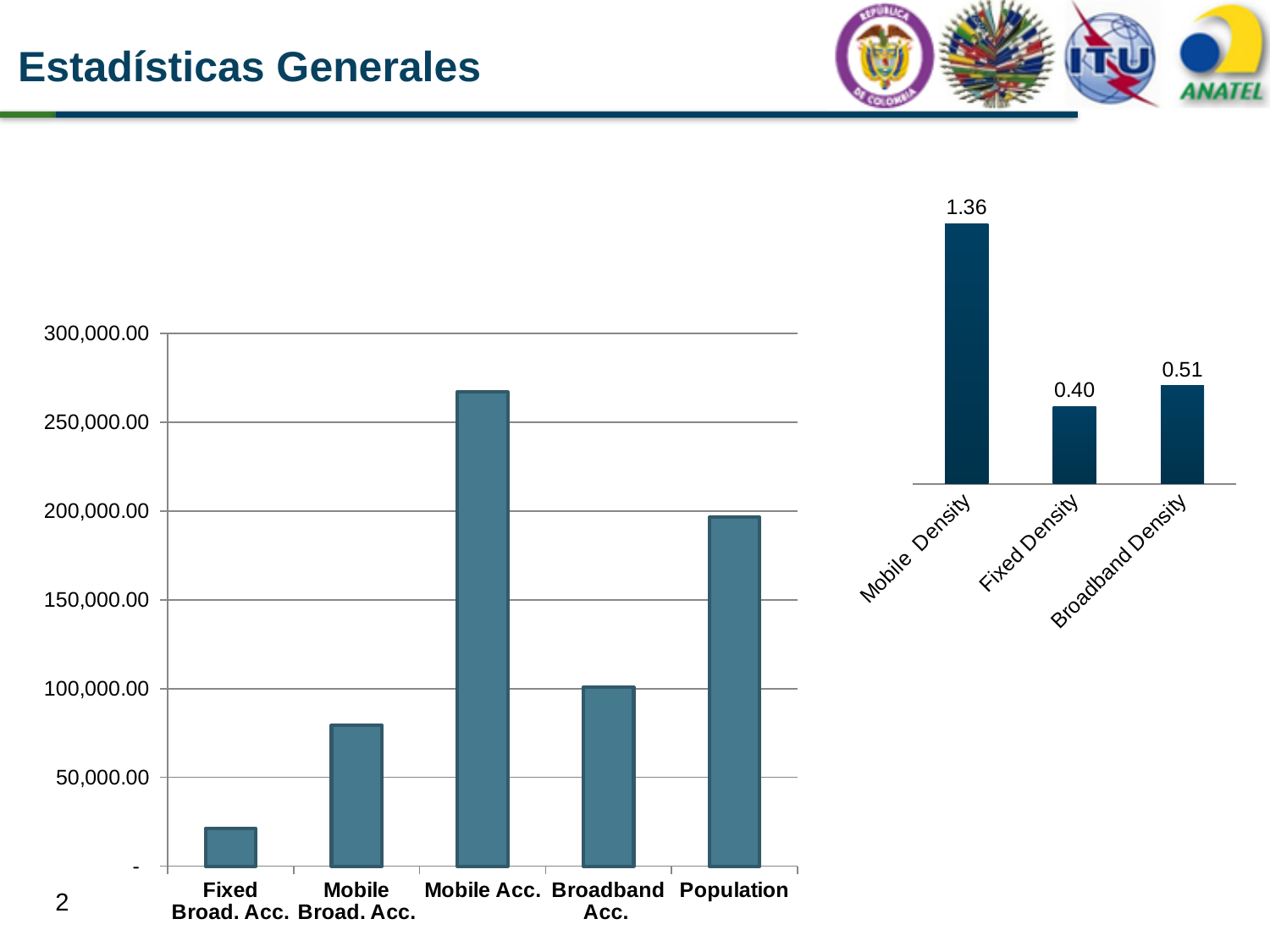
In the chart on the right, what is the value for Fixed Density? 0.40 In the chart on the right, what is the value for Mobile Density? 1.36 In the chart on the left, is the value for Mobile Broad. Acc. greater or less than 100,000.00? less In the chart on the right, what is the difference between Mobile Density and Fixed Density? 0.96 In the chart on the right, which category has the highest value? Mobile Density In the chart on the left, which category has the highest bar? Mobile Acc. In the chart on the right, how many categories are shown? 3 In the chart on the right, which category has the lowest value? Fixed Density In the chart on the left, which category has the lowest bar? Fixed Broad. Acc. In the chart on the right, what is the value for Broadband Density? 0.51 In the chart on the left, is the value for Population greater or less than 150,000.00? greater What kind of chart is the chart on the left? Bar chart